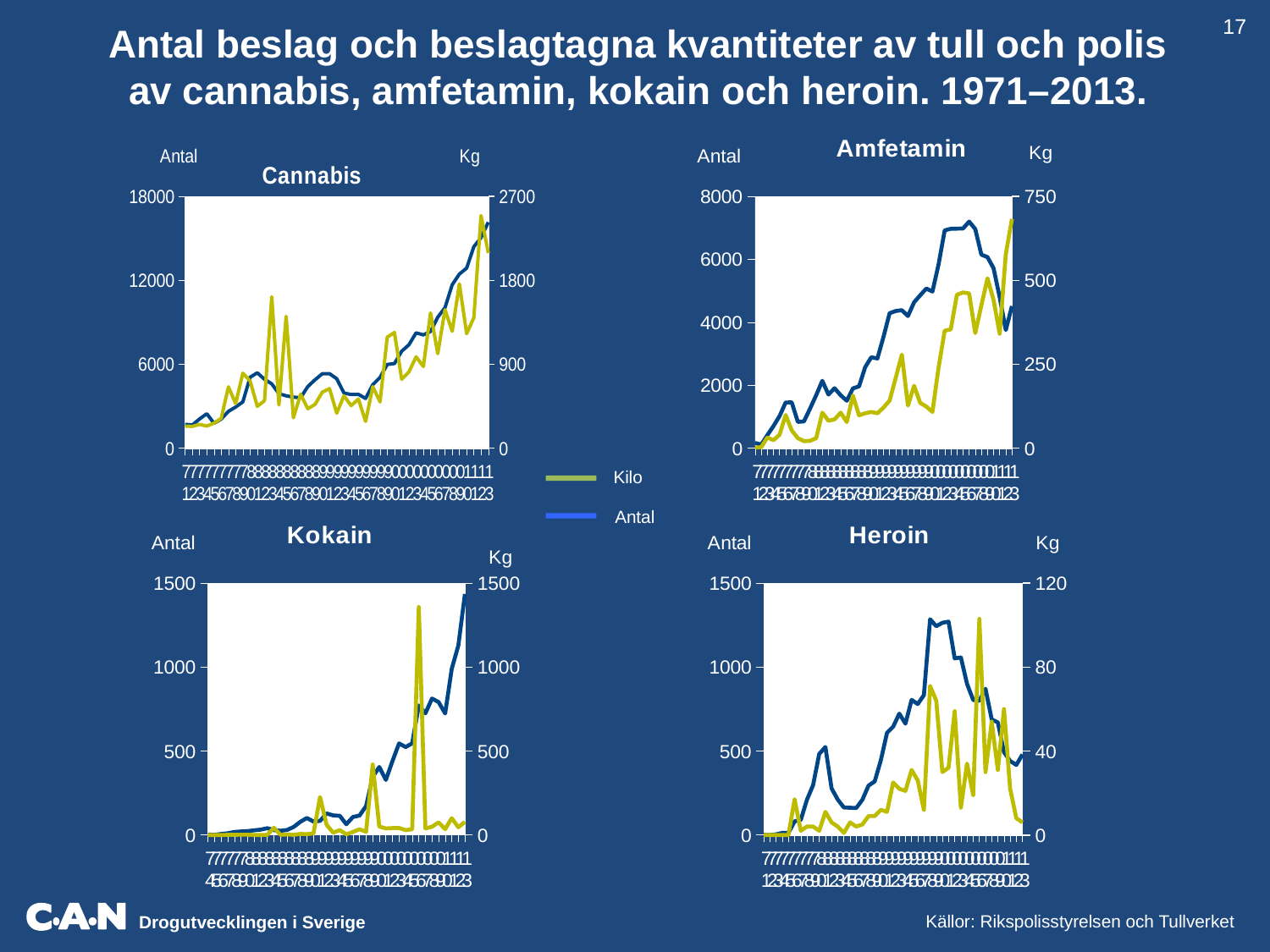
In the Kokain chart, is the highest value of the Kilo series greater or less than 1000? greater In the Cannabis chart, is the highest value of the Kilo series greater or less than 1800? greater What are the two entries in the legend? Kilo and Antal How many charts are shown on the slide? 4 In the Amfetamin chart, is the highest value of the Antal series greater or less than 6000? greater In the Cannabis chart, does the Antal series generally rise or fall from left to right? rise How many series does the legend list? 2 In the Amfetamin chart, does the Antal series generally rise or fall from left to right? rise In the Heroin chart, what is the maximum value shown on the right-hand Kg axis? 120 What kind of chart is the Cannabis chart? line chart